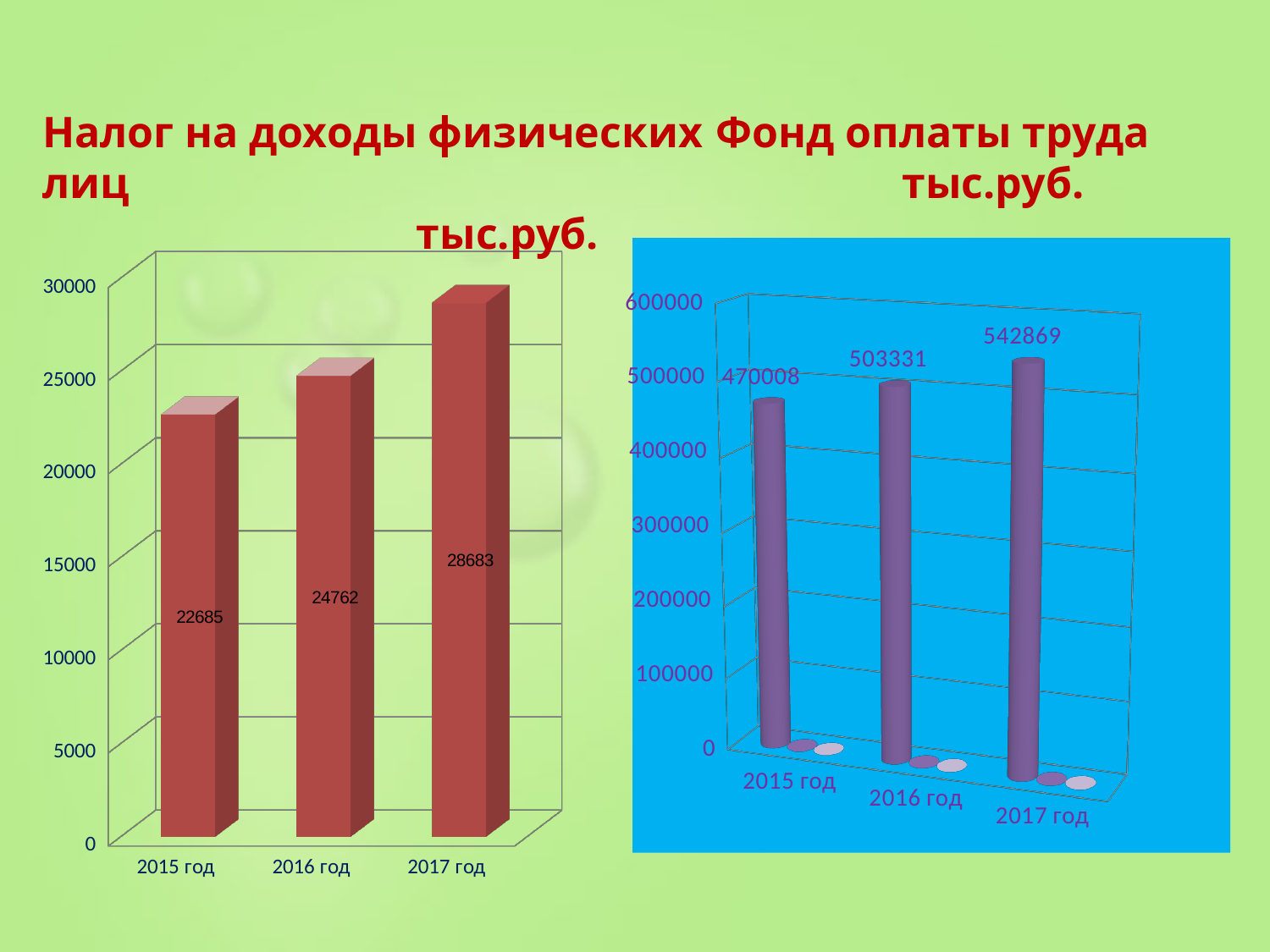
In the right chart (Фонд оплаты труда), is the value for 2017 год greater or less than 500000? greater In the left chart (Налог на доходы физических лиц), which is larger: the value for 2016 год or 2015 год? 2016 год In the left chart (Налог на доходы физических лиц), which year has the highest value? 2017 год In the right chart (Фонд оплаты труда), what is the value for 2016 год? 503331 How many years are shown in the left chart (Налог на доходы физических лиц)? 3 Do the values in the right chart (Фонд оплаты труда) rise or fall from 2015 год to 2017 год? rise In the left chart (Налог на доходы физических лиц), what is the value for 2017 год? 28683 In the right chart (Фонд оплаты труда), what is the value for 2017 год? 542869 In the right chart (Фонд оплаты труда), which year has the lowest value? 2015 год In the left chart (Налог на доходы физических лиц), what is the difference between the values for 2017 год and 2015 год? 5998 In the left chart (Налог на доходы физических лиц), what is the value for 2015 год? 22685 In the right chart (Фонд оплаты труда), what is the difference between the values for 2016 год and 2015 год? 33323